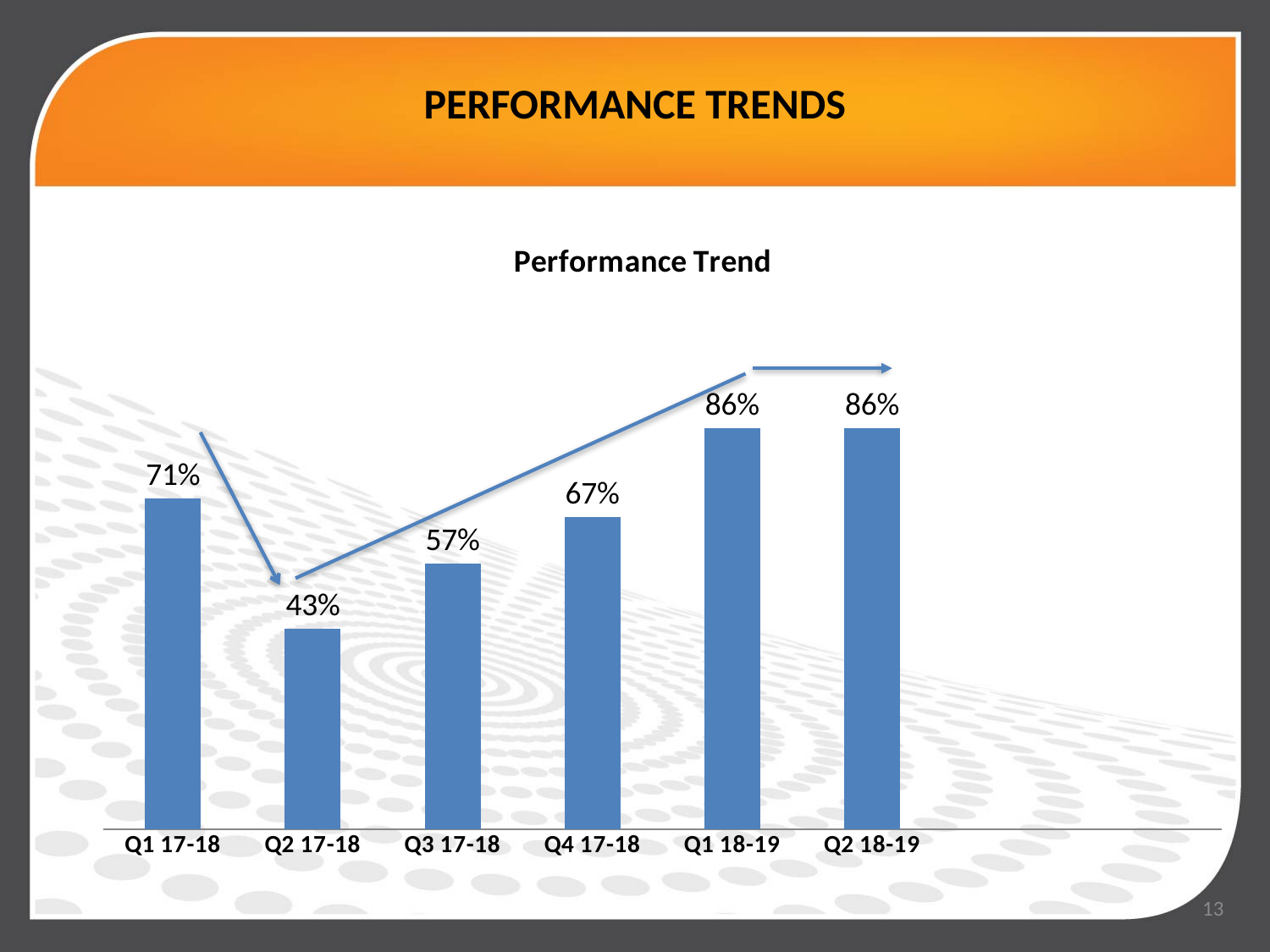
What is the value for Q4 17-18? 67% What is the difference between the values for Q1 18-19 and Q3 17-18? 29% Which quarter has the lowest value? Q2 17-18 What is the title of the chart? Performance Trend What is the value for Q1 17-18? 71% Do the values rise or fall from Q2 17-18 to Q1 18-19? Rise How many quarters are shown on the chart? 6 Which is larger, the value for Q3 17-18 or the value for Q4 17-18? Q4 17-18 What is the value for Q1 18-19? 86% What is the difference between the values for Q1 17-18 and Q2 17-18? 28% What kind of chart is shown on the slide? Bar chart What is the value for Q2 17-18? 43%